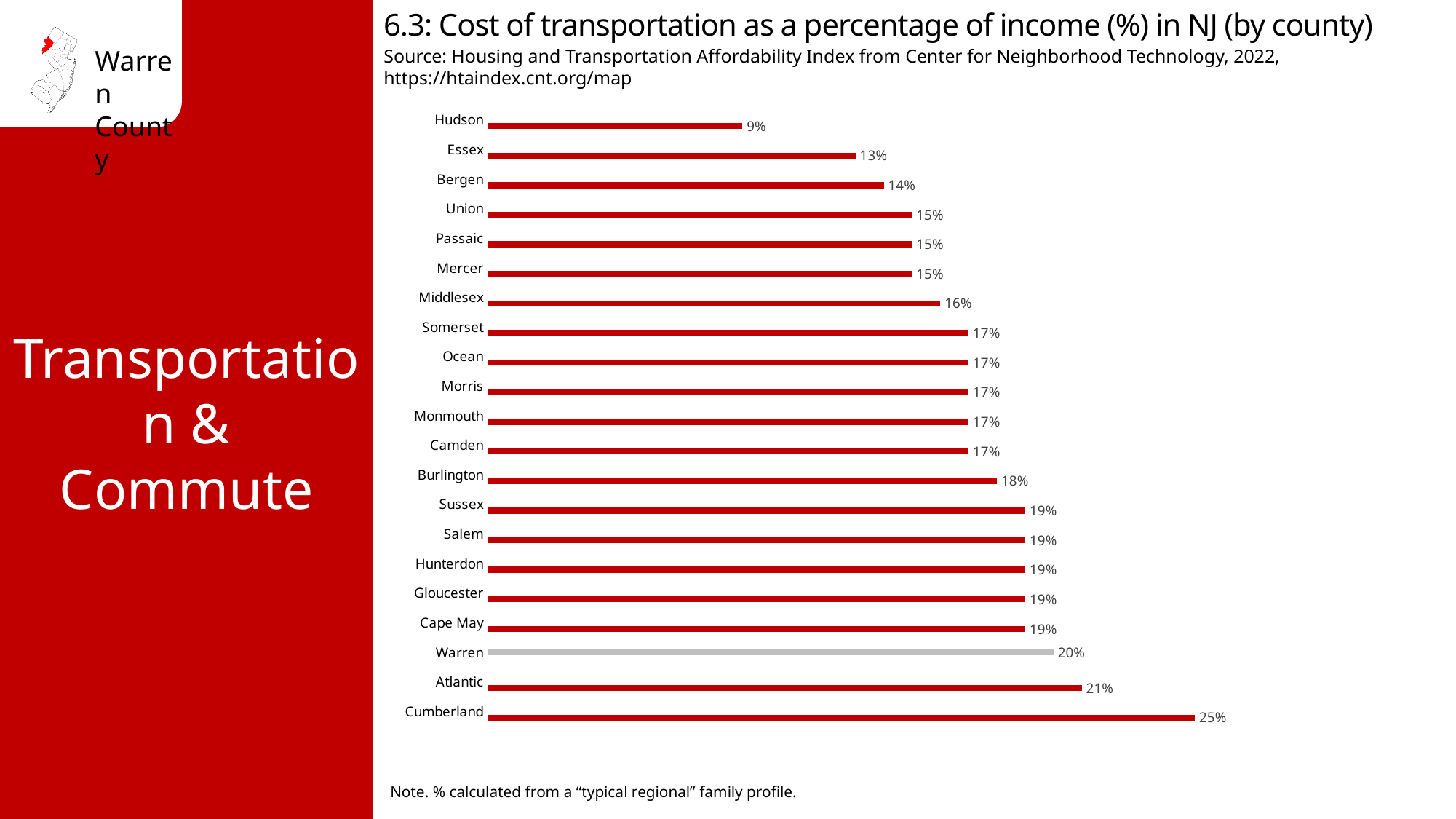
What is the value shown for Hudson county? 9% What is the difference between the values for Cumberland and Hudson? 16% What is the difference between the values for Atlantic and Warren? 1% What kind of chart is shown on the slide? Bar chart Which has a higher value, Essex or Burlington? Burlington What is the value shown for Middlesex county? 16% Which has a higher value, Warren or Bergen? Warren Which county has the lowest cost of transportation as a percentage of income? Hudson What is the cost of transportation as a percentage of income for Warren county? 20% Which county's bar is shown in grey rather than red? Warren Which county has the highest cost of transportation as a percentage of income? Cumberland How many counties are shown in the chart? 21